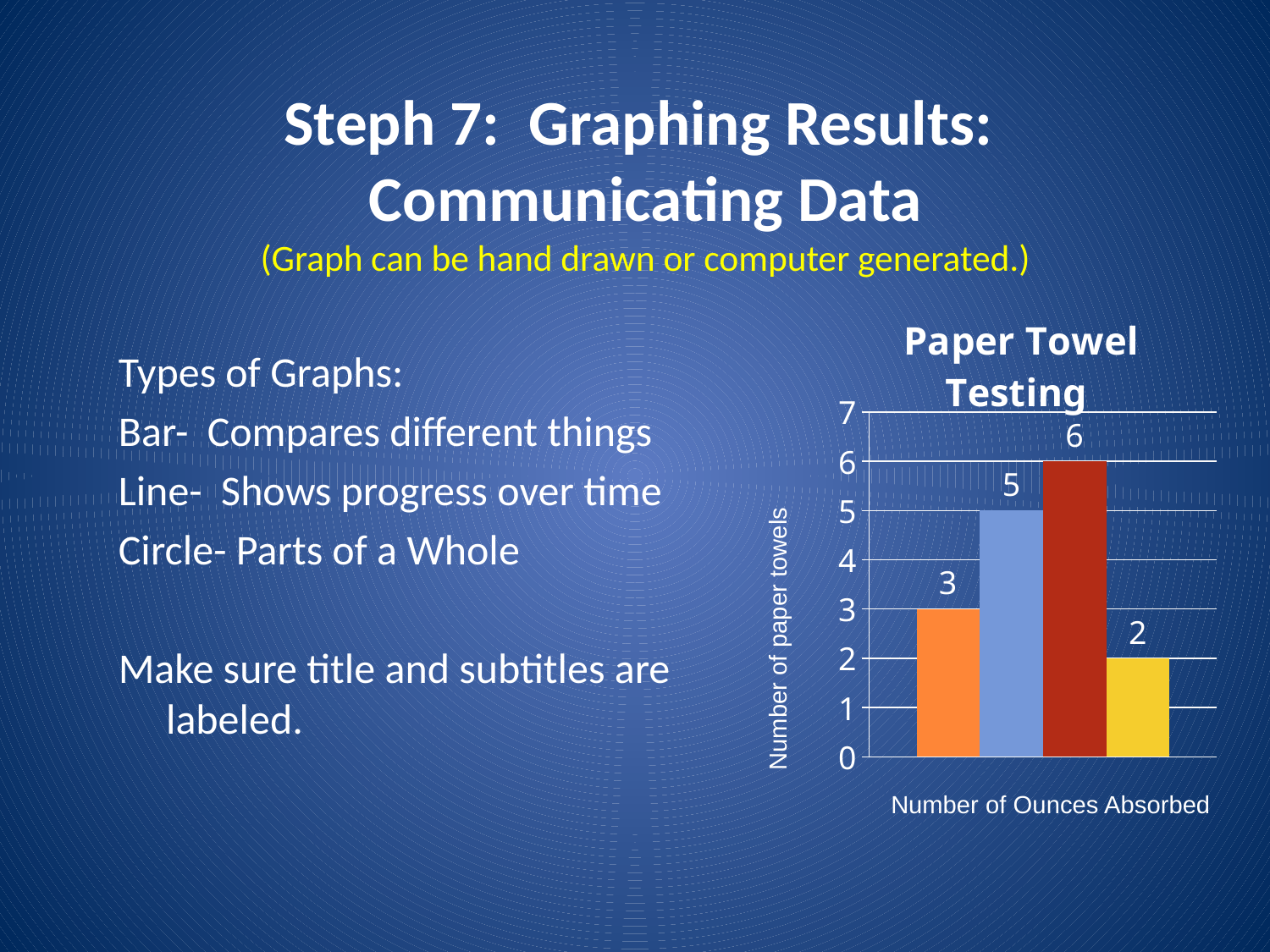
How many bars are plotted in the Paper Towel Testing chart? 4 What is the label of the vertical axis in the Paper Towel Testing chart? Number of paper towels What type of chart is shown on the slide? bar chart What is the value of the blue (second) bar in the Paper Towel Testing chart? 5 What is the value of the red (third) bar in the Paper Towel Testing chart? 6 Which is larger in the Paper Towel Testing chart, the orange bar or the blue bar? the blue bar What is the title of the chart on the slide? Paper Towel Testing What is the difference between the red bar and the yellow bar in the Paper Towel Testing chart? 4 What is the value of the yellow (fourth) bar in the Paper Towel Testing chart? 2 Which bar has the lowest value in the Paper Towel Testing chart? the yellow (fourth) bar Which bar has the highest value in the Paper Towel Testing chart? the red (third) bar What is the value of the orange (first) bar in the Paper Towel Testing chart? 3